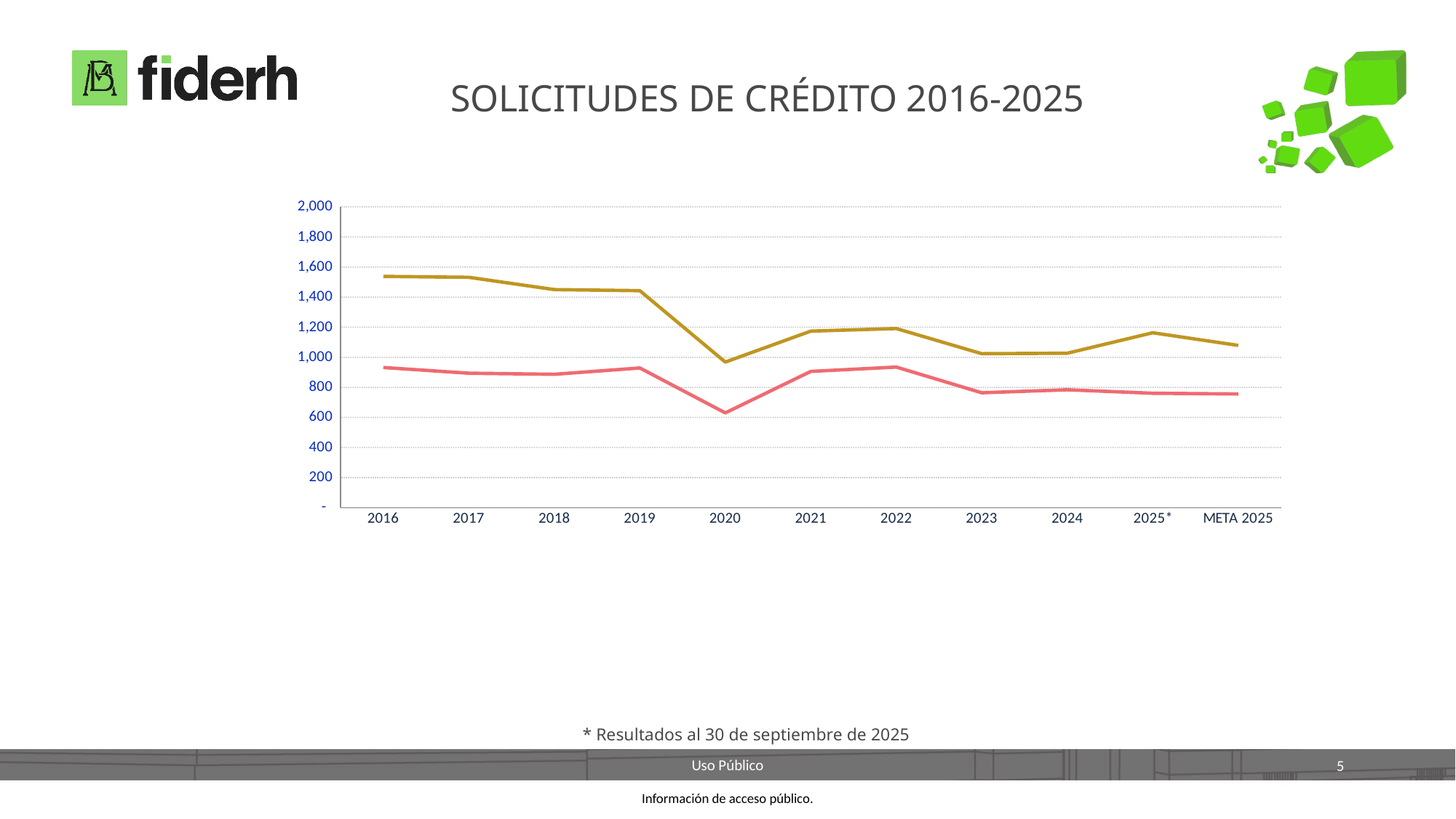
What kind of chart is shown on the slide? line chart Does the lower (red) line rise or fall from 2020 to 2022? rise Does the upper (gold) line rise or fall from 2016 to 2020? fall Is the value of the upper (gold) line for 2016 greater or less than 1,400? greater How many categories are shown along the x axis of the chart? 11 In which year does the lower (red) line reach its lowest value? 2020 How many lines are plotted on the chart? 2 Is the value of the upper (gold) line for 2020 greater or less than 1,200? less Is the value of the lower (red) line for 2020 greater or less than 800? less Which is larger for the upper (gold) line: the value for 2019 or the value for 2021? 2019 What is the title of the chart on the slide? SOLICITUDES DE CRÉDITO 2016-2025 In which year does the upper (gold) line reach its lowest value? 2020